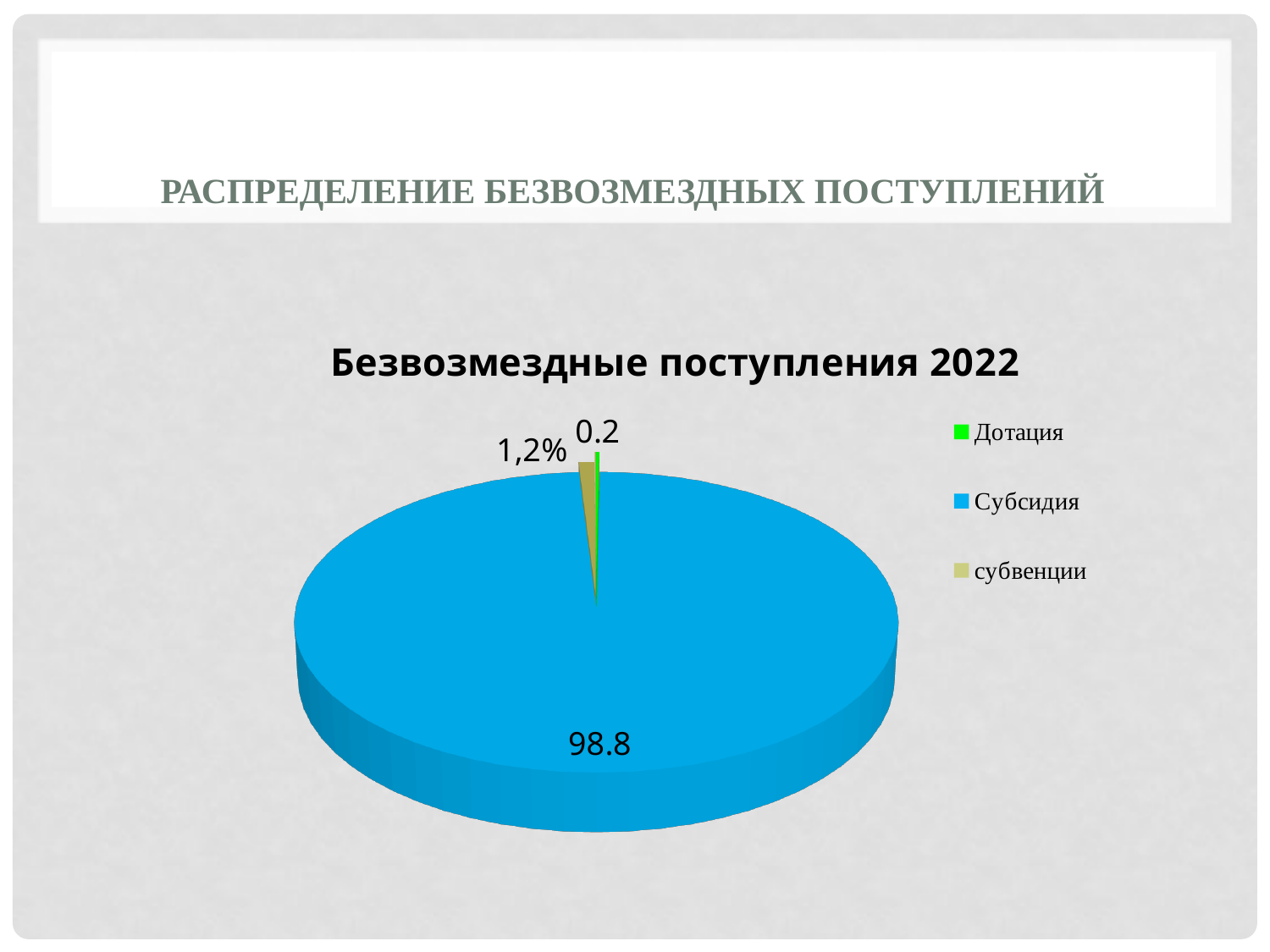
Which category has the smallest slice of the pie? Дотация What value is shown for Субсидия? 98.8 Which is larger, the slice for субвенции or the slice for Дотация? субвенции What value is shown for Дотация? 0.2 What kind of chart is shown on the slide? Pie chart What is the title of the chart? Безвозмездные поступления 2022 How many entries does the legend list? 3 Which category has the largest slice of the pie? Субсидия What colour is the slice for Субсидия? Blue What is the difference between the values for Субсидия and Дотация? 98.6 What value is shown for субвенции? 1,2% How many slices does the pie chart have? 3